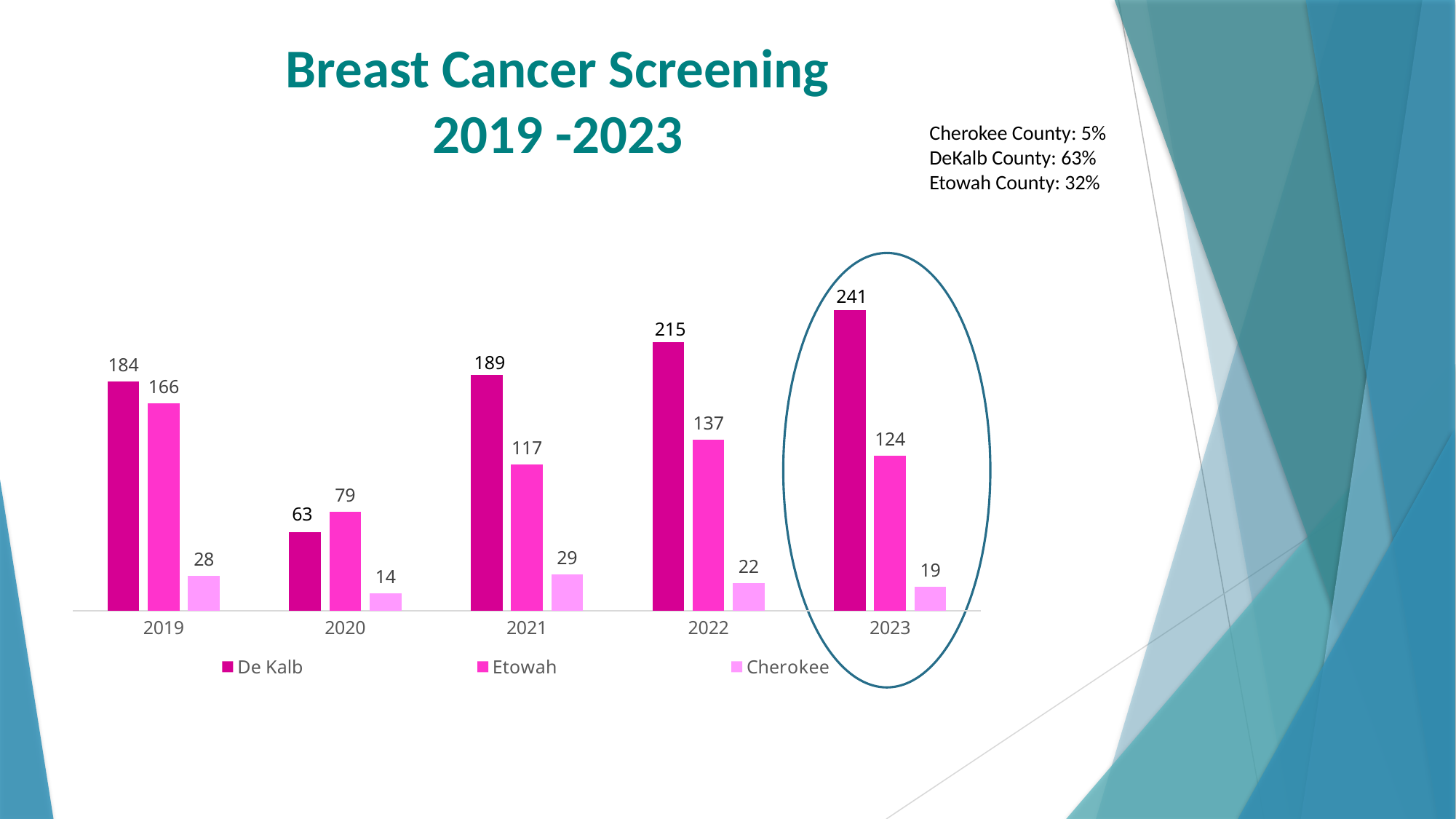
What is the Etowah value for 2020? 79 What is the title of the chart? Breast Cancer Screening 2019 -2023 What is the De Kalb value for 2023? 241 What kind of chart is shown on the slide? Bar chart In which year is the De Kalb value highest? 2023 How many years are shown on the x axis? 5 In which year is the Cherokee value lowest? 2020 How many series does the legend list? 3 Does the De Kalb value rise or fall from 2020 to 2023? Rise Which is larger in 2020, the De Kalb value or the Etowah value? Etowah What is the difference between the De Kalb and Etowah values in 2022? 78 What is the Cherokee value for 2021? 29